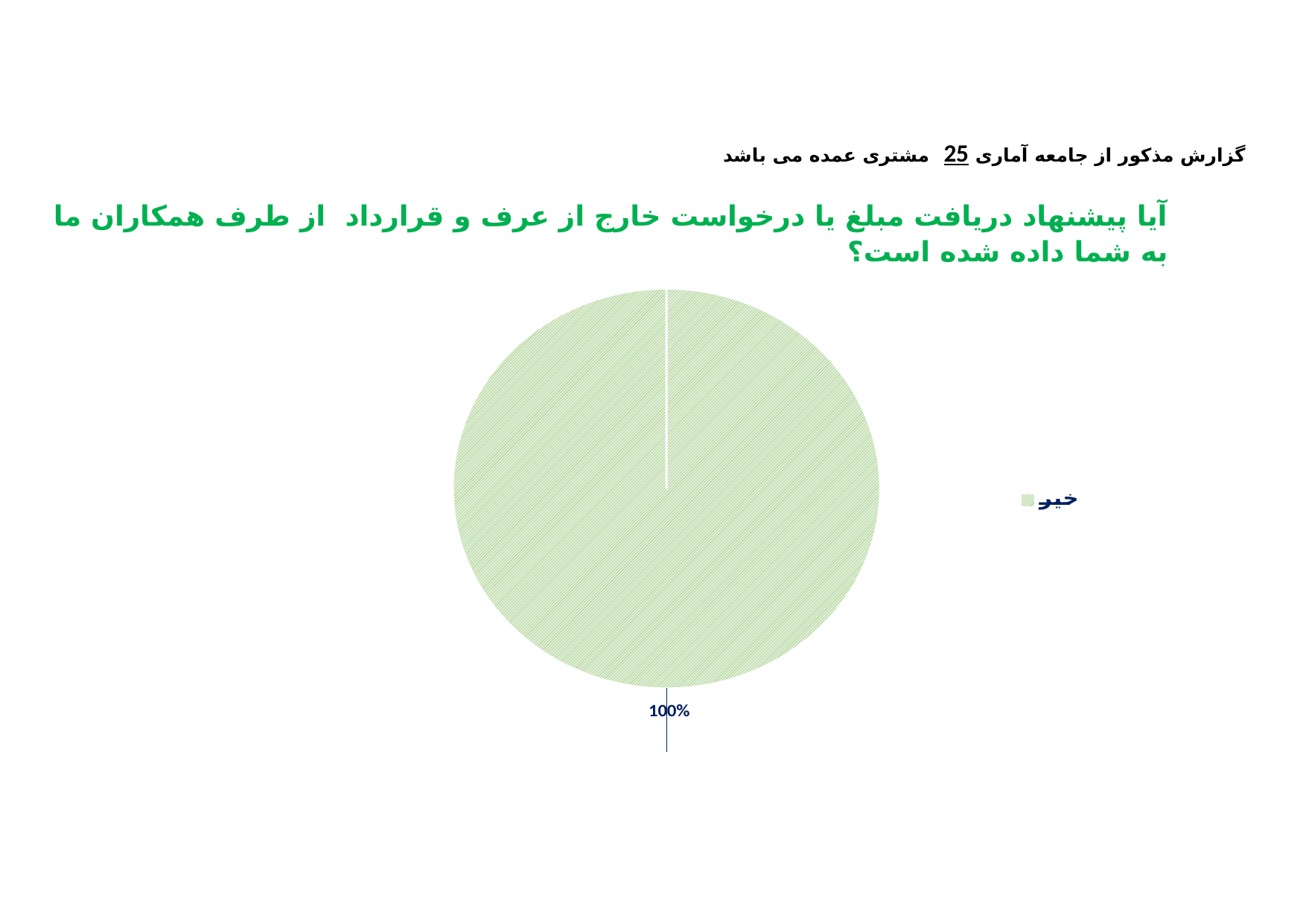
According to the text above the chart, how many major customers make up the statistical population? 25 How many slices does the pie chart have? 1 What share of the pie does the "خیر" slice represent? 100% Which category makes up the entire pie? خیر What kind of chart is shown on the slide? pie chart Is the share of the "خیر" slice greater or less than 50%? greater How many entries does the legend list? 1 What is the data label printed on the pie slice? 100% What is the legend entry for the pie chart? خیر